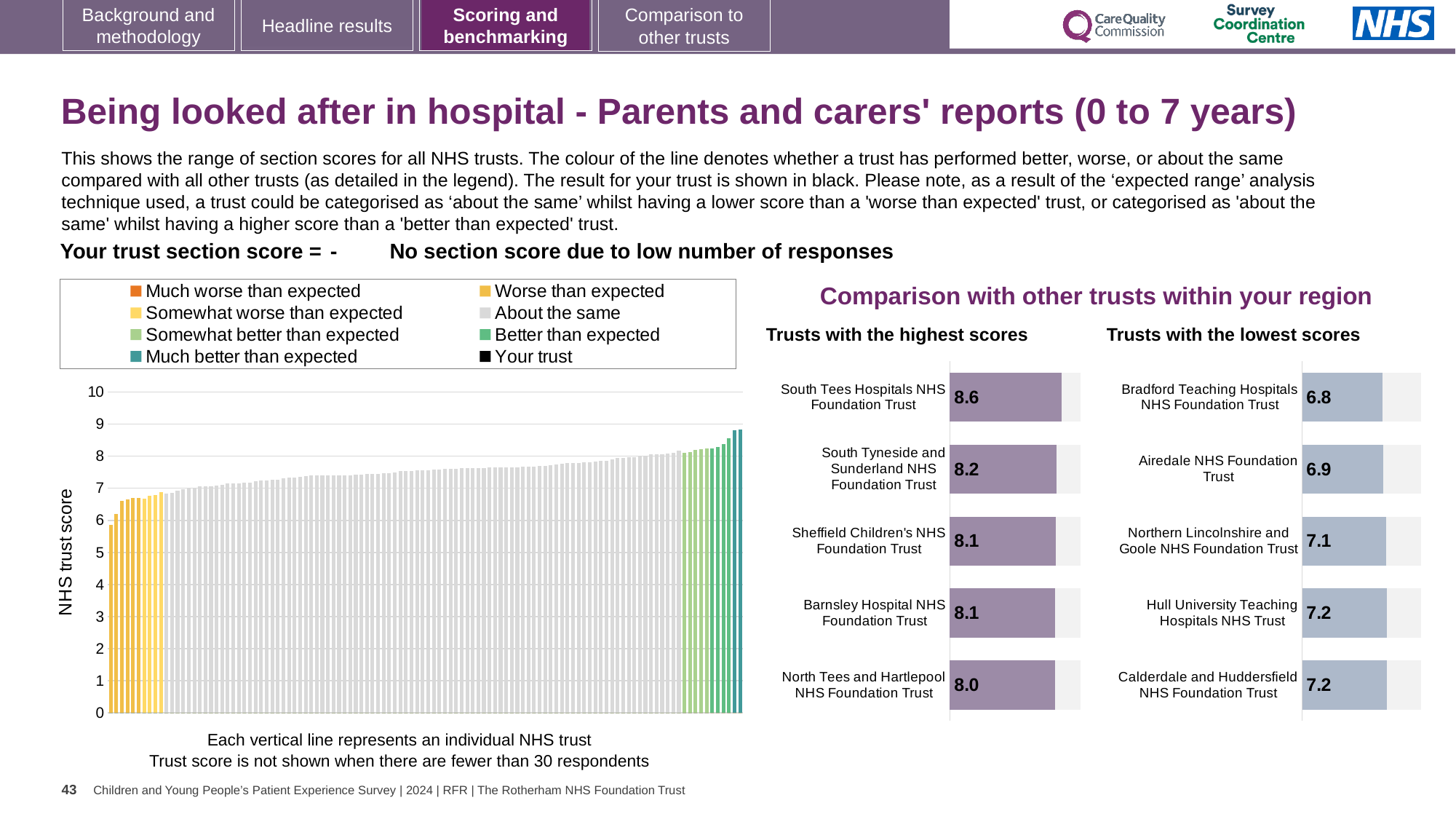
What kind of chart is the large chart on the left showing the NHS trust scores? Bar chart In the 'Trusts with the highest scores' chart, what is the score for South Tees Hospitals NHS Foundation Trust? 8.6 In the 'Trusts with the lowest scores' chart, what is the score for Bradford Teaching Hospitals NHS Foundation Trust? 6.8 How many trusts are listed in the 'Trusts with the lowest scores' chart? 5 In the 'Trusts with the highest scores' chart, what is the score for North Tees and Hartlepool NHS Foundation Trust? 8.0 In the 'Trusts with the lowest scores' chart, what is the score for Northern Lincolnshire and Goole NHS Foundation Trust? 7.1 In the 'Trusts with the lowest scores' chart, which has the larger score: Airedale NHS Foundation Trust or Hull University Teaching Hospitals NHS Trust? Hull University Teaching Hospitals NHS Trust In the 'Trusts with the highest scores' chart, which trust has the highest score? South Tees Hospitals NHS Foundation Trust How many entries does the legend above the large chart on the left list? 8 In the 'Trusts with the lowest scores' chart, which trust has the lowest score? Bradford Teaching Hospitals NHS Foundation Trust In the 'Trusts with the highest scores' chart, what is the difference between the scores of South Tees Hospitals NHS Foundation Trust and South Tyneside and Sunderland NHS Foundation Trust? 0.4 In the large chart on the left, is the value of the tallest bar greater or less than 8? greater